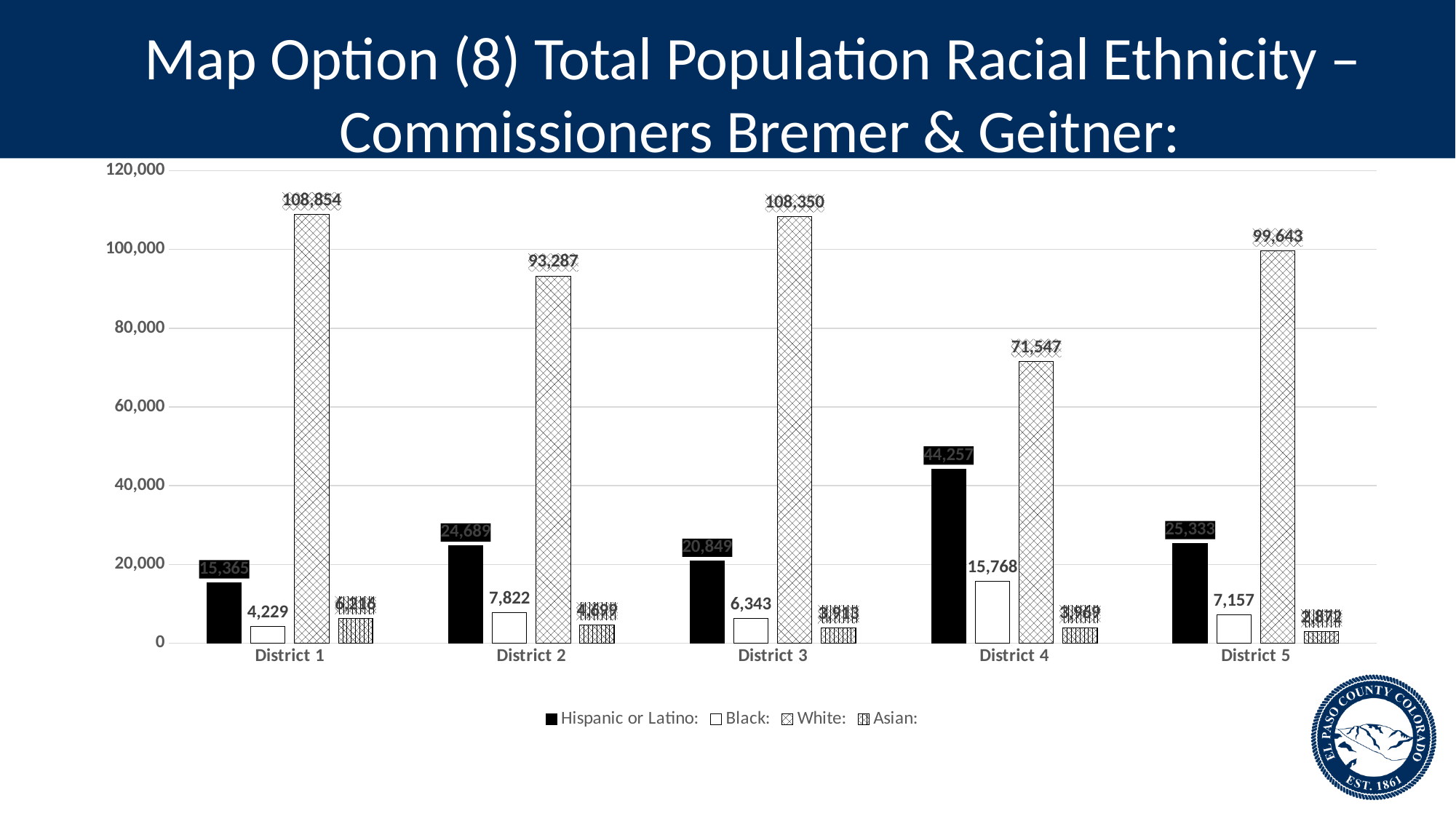
What is the White population value for District 1? 108,854 What is the Black population value for District 2? 7,822 What kind of chart is shown on the slide? Bar chart Which is larger, the Black population of District 3 or District 5? District 5 What is the difference between the White population of District 1 and District 2? 15,567 Which district has the lowest White population? District 4 What is the White population value for District 5? 99,643 What is the Hispanic or Latino population value for District 4? 44,257 Which district has the highest Hispanic or Latino population? District 4 How many districts are shown on the x axis? 5 Which district has the lowest Black population? District 1 How many series does the legend list? 4